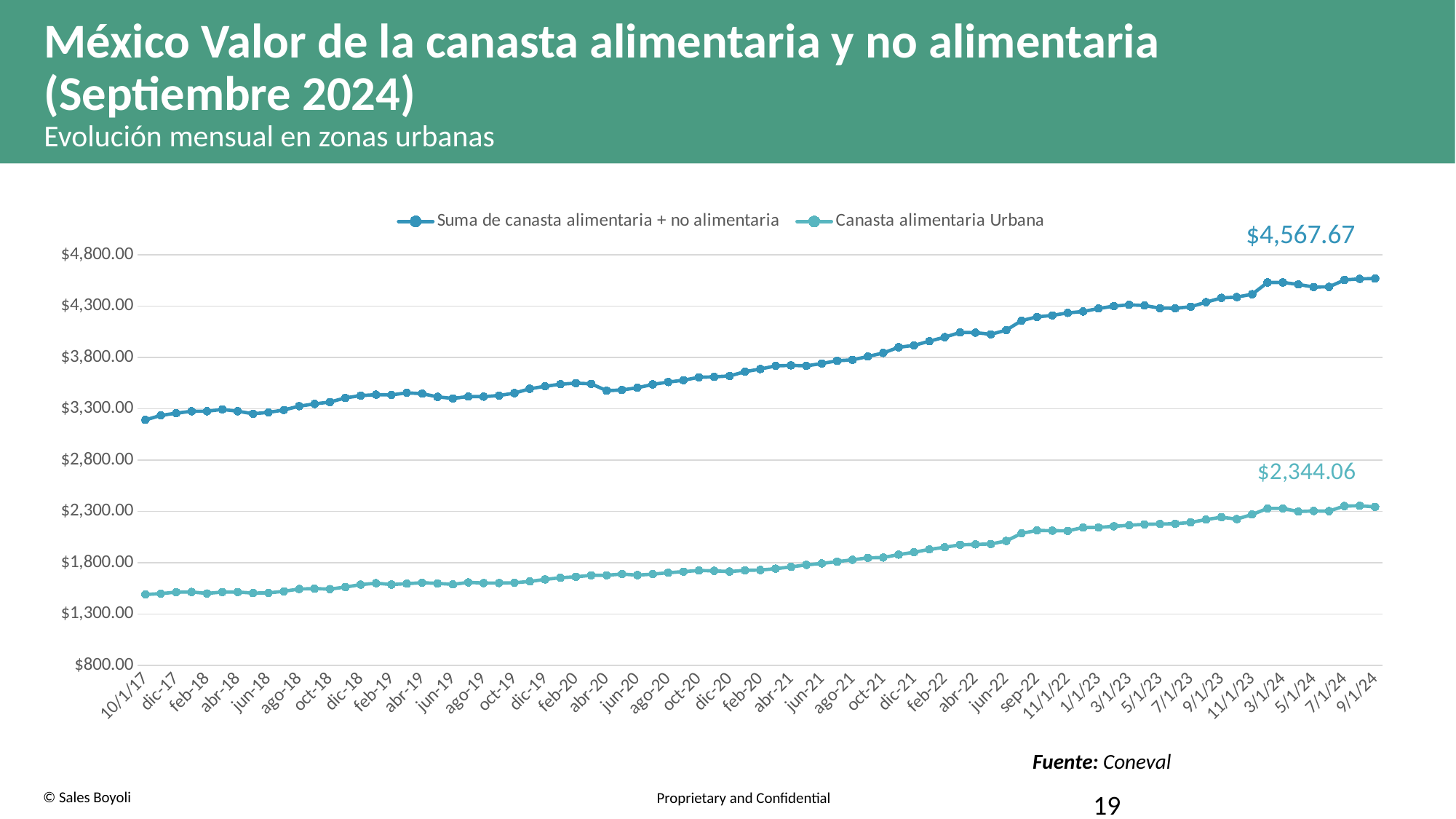
Is the value of 'Suma de canasta alimentaria + no alimentaria' at 9/1/24 greater or less than $4,300.00? greater What is the value of the 'Suma de canasta alimentaria + no alimentaria' series at 9/1/24? $4,567.67 How many series does the legend list? 2 What source is cited for the chart data? Coneval Is the value of 'Canasta alimentaria Urbana' at 9/1/24 greater or less than $1,800.00? greater What is the difference between the two labelled values at 9/1/24 ($4,567.67 and $2,344.06)? $2,223.61 Do the values of 'Canasta alimentaria Urbana' generally rise or fall from 10/1/17 to 9/1/24? Rise Is the value of 'Canasta alimentaria Urbana' at 10/1/17 greater or less than $1,800.00? less What kind of chart is shown on the slide? Line chart At 9/1/24, which series has the larger value: 'Suma de canasta alimentaria + no alimentaria' or 'Canasta alimentaria Urbana'? Suma de canasta alimentaria + no alimentaria What is the value of the 'Canasta alimentaria Urbana' series at 9/1/24? $2,344.06